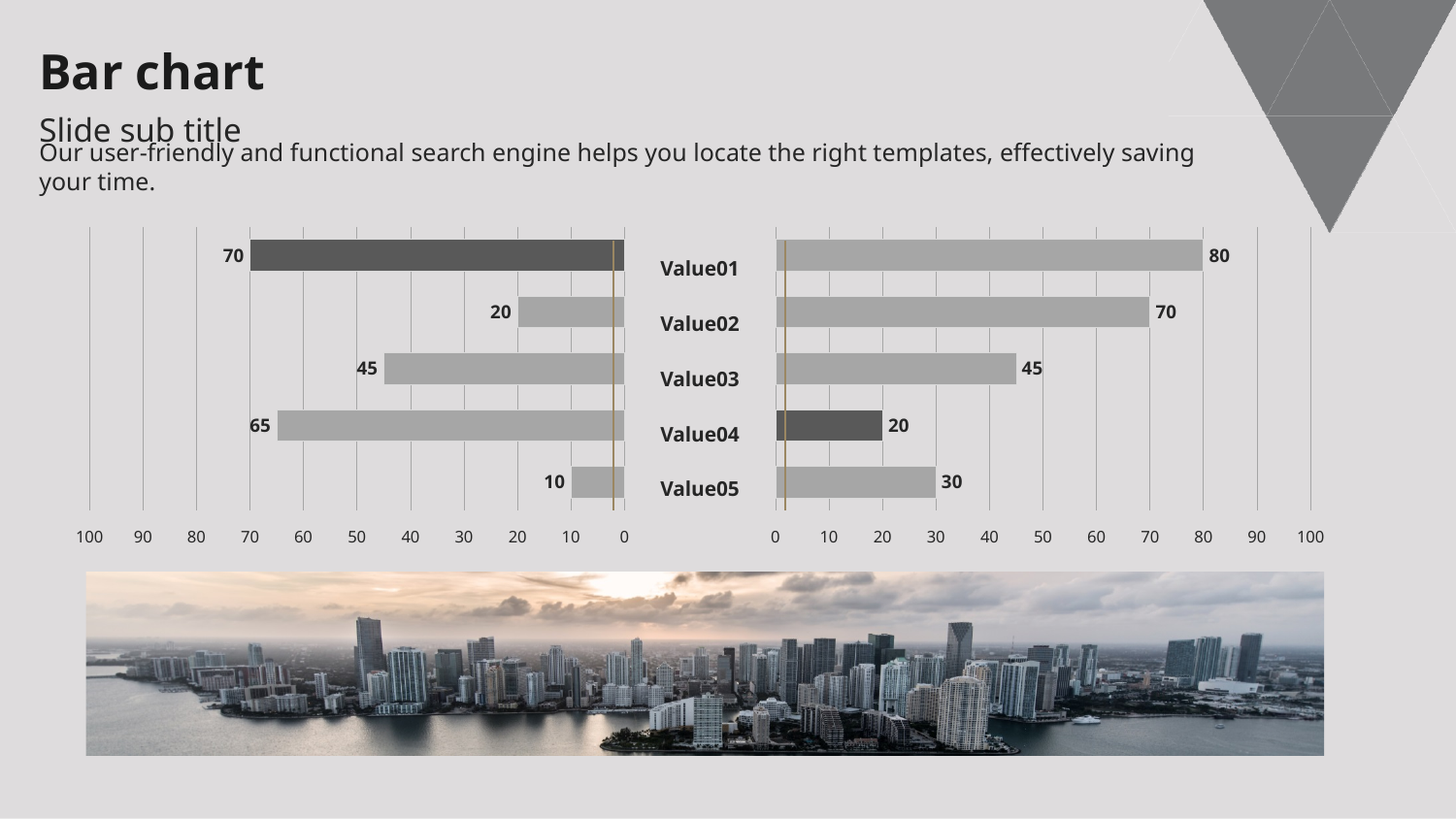
In the left chart, what is the value for Value01? 70 In the right chart, which category has the highest value? Value01 In the right chart, which category has the lowest value? Value04 In the left chart, what is the value for Value04? 65 In the left chart, which is larger, the value for Value03 or the value for Value02? Value03 In the right chart, which bar is drawn in a darker colour than the others? Value04 In the right chart, what is the value for Value05? 30 What kind of chart is the left chart? Bar chart In the right chart, what is the difference between the values for Value01 and Value02? 10 In the left chart, what is the difference between the values for Value04 and Value02? 45 In the left chart, which category has the lowest value? Value05 How many categories are shown in the right chart? 5